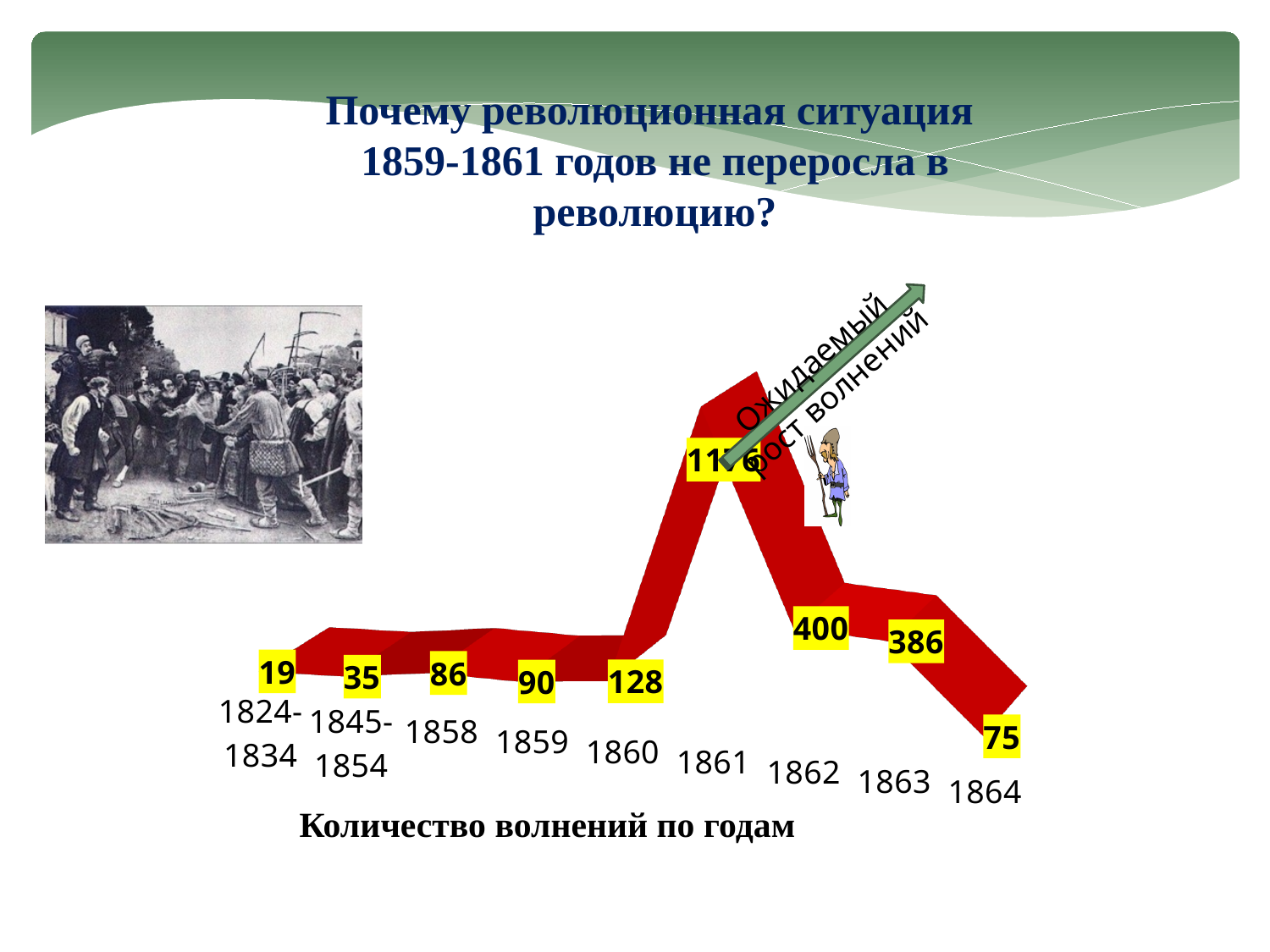
What is the caption of the chart? Количество волнений по годам What value is shown for the period 1824-1834? 19 What is the number of disturbances shown for 1860? 128 What value is shown for 1864? 75 How many time periods are plotted on the chart? 9 What is the difference between the values for 1862 and 1863? 14 Which year has the highest number of disturbances? 1861 Do the values rise or fall from 1862 to 1864? fall What is the difference between the values for 1860 and 1859? 38 What value is shown for 1862? 400 Which period has the lowest number of disturbances? 1824-1834 Which is larger, the value for 1858 or the value for 1845-1854? 1858